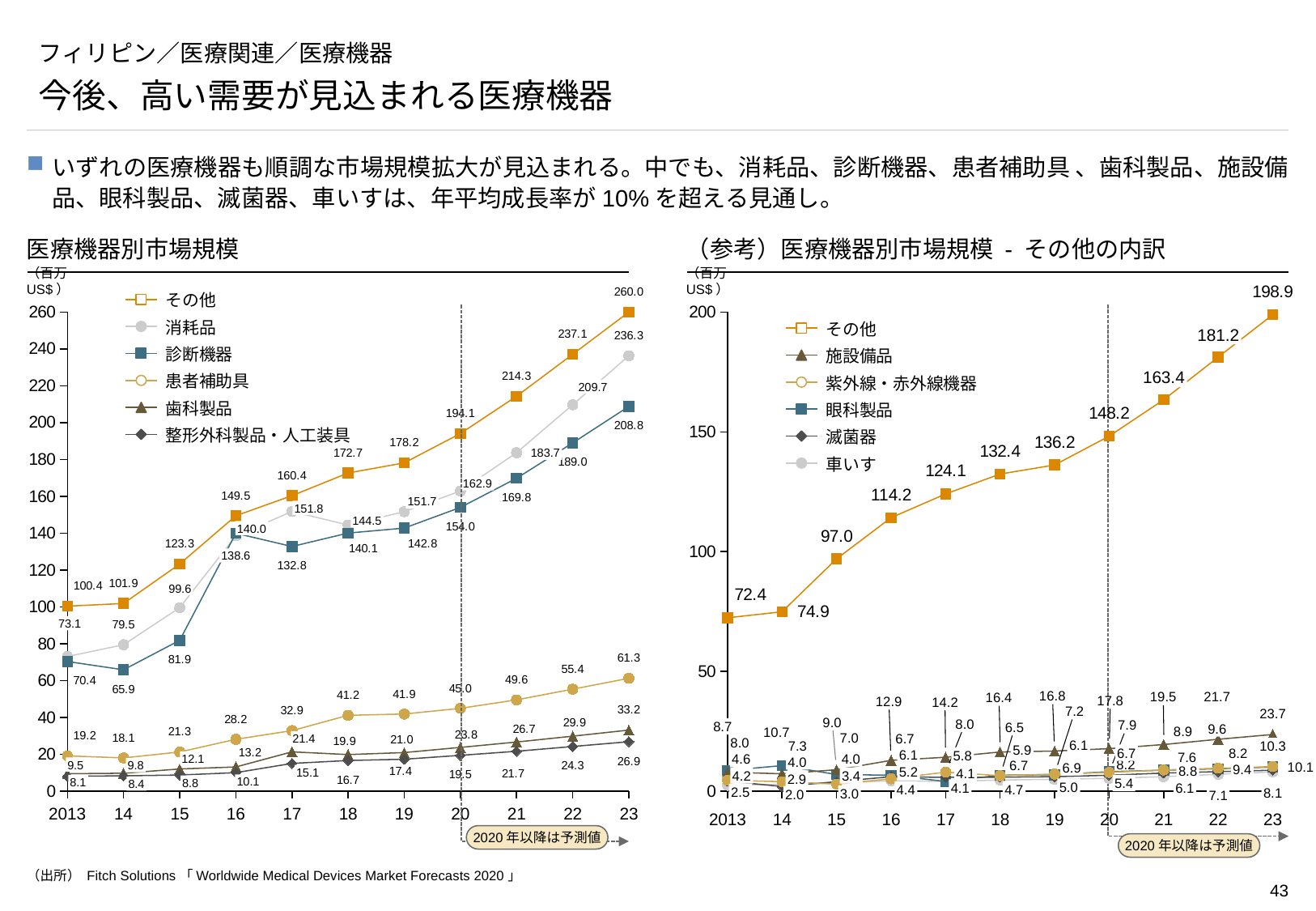
In the right chart ((参考) 医療機器別市場規模 - その他の内訳), what is the value for その他 in 2020? 148.2 In the left chart (医療機器別市場規模), what is the value for 患者補助具 in 2018? 41.2 In the left chart (医療機器別市場規模), which series has the highest value in 2023? その他 How many series does the legend of the left chart (医療機器別市場規模) list? 6 In the left chart (医療機器別市場規模), which series has the lowest value in 2023? 整形外科製品・人工装具 What kind of chart is the right chart ((参考) 医療機器別市場規模 - その他の内訳)? line chart In the right chart ((参考) 医療機器別市場規模 - その他の内訳), what is the difference between the その他 values for 2023 and 2022? 17.7 In the right chart ((参考) 医療機器別市場規模 - その他の内訳), does the その他 series rise or fall from 2013 to 2023? rise In the left chart (医療機器別市場規模), what is the value for 消耗品 in 2020? 162.9 In the left chart (医療機器別市場規模), what is the difference between the その他 values for 2023 and 2013? 159.6 In the left chart (医療機器別市場規模), which is larger in 2022: 消耗品 or 診断機器? 消耗品 In the left chart (医療機器別市場規模), what is the value for その他 in 2023? 260.0